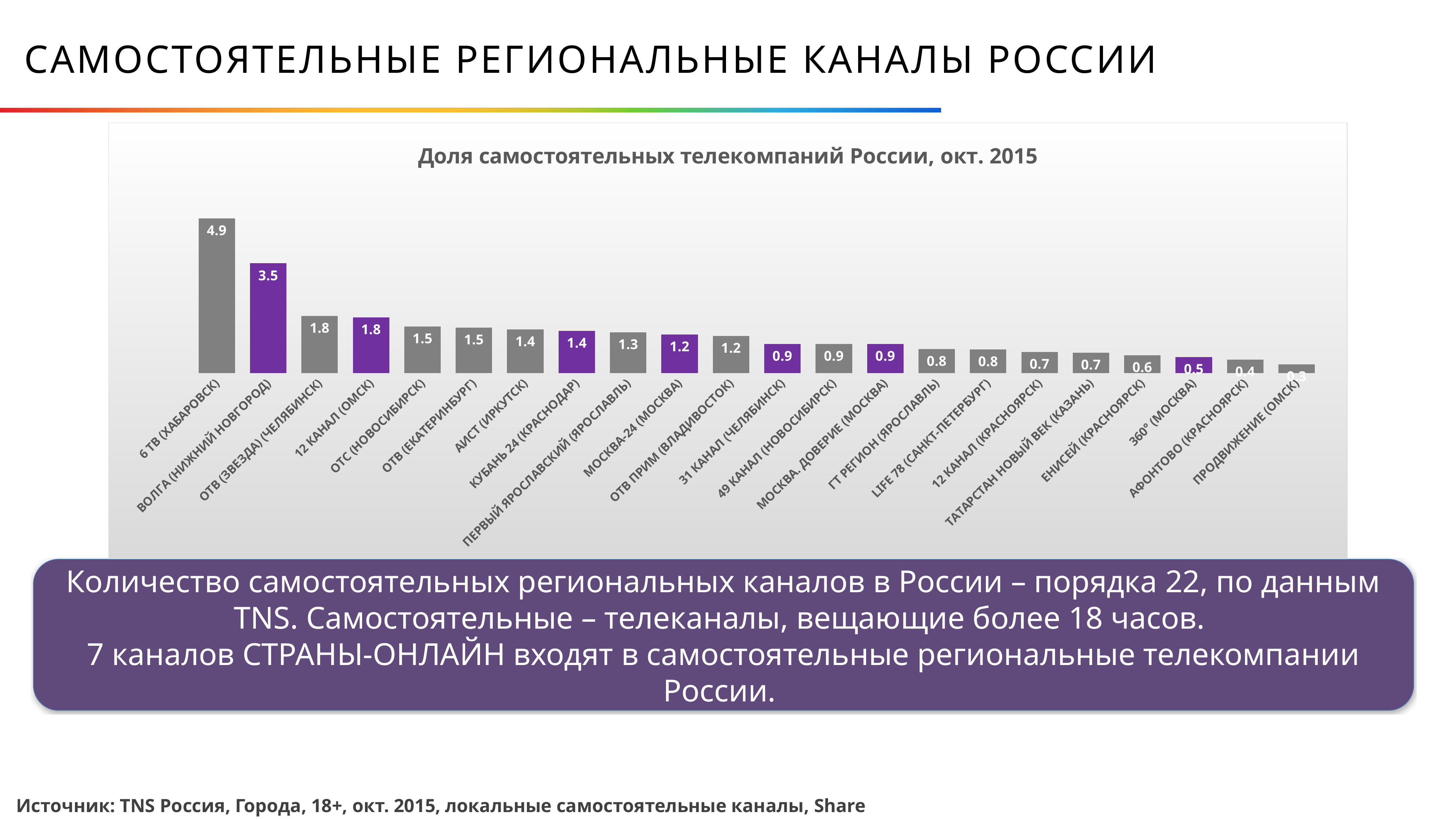
What is the title of the chart? Доля самостоятельных телекомпаний России, окт. 2015 Which channel has the highest share? 6 ТВ (ХАБАРОВСК) How many channels are shown in the chart? 22 What is the value for КУБАНЬ 24 (КРАСНОДАР)? 1.4 Which is larger, the value for 12 КАНАЛ (ОМСК) or the value for МОСКВА-24 (МОСКВА)? 12 КАНАЛ (ОМСК) What is the value for LIFE 78 (САНКТ-ПЕТЕРБУРГ)? 0.8 What is the value for 6 ТВ (ХАБАРОВСК)? 4.9 What is the difference between the values for 6 ТВ (ХАБАРОВСК) and ВОЛГА (НИЖНИЙ НОВГОРОД)? 1.4 Which channel has the lowest share? ПРОДВИЖЕНИЕ (ОМСК) What is the value for ВОЛГА (НИЖНИЙ НОВГОРОД)? 3.5 What kind of chart is shown on the slide? Bar chart Do the values rise or fall from left to right along the x axis? Fall